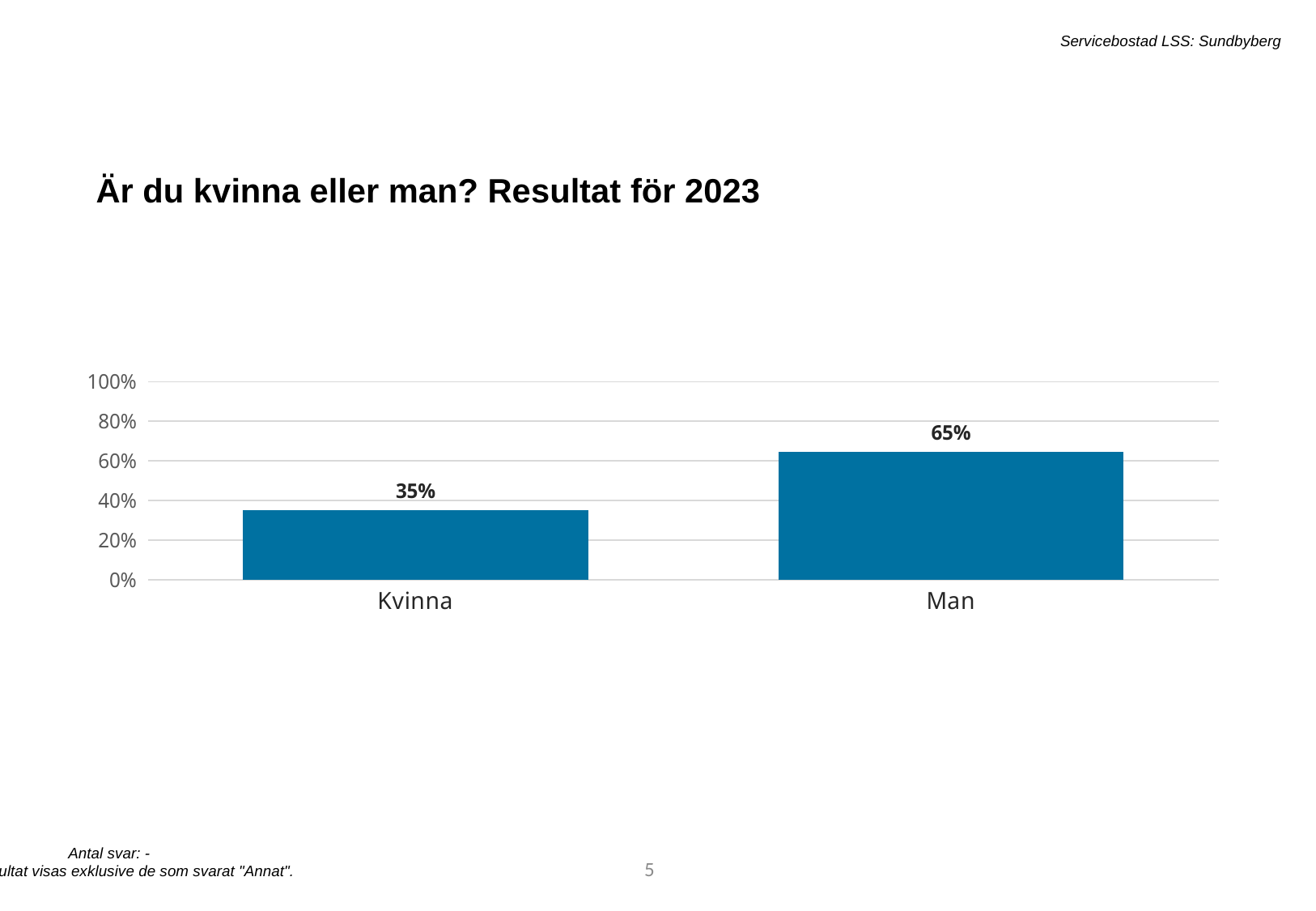
What is the difference between the values for Man and Kvinna? 30% Which category has the lowest value? Kvinna Which is larger, the value for Kvinna or the value for Man? Man What kind of chart is shown on the slide? bar chart What is the highest value shown on the y axis? 100% Is the value for Kvinna greater or less than 40%? less What is the title of the slide's chart? Är du kvinna eller man? Resultat för 2023 How many categories are shown on the x axis? 2 What is the value for Man? 65% What is the value for Kvinna? 35% Which category has the highest value? Man Is the value for Man greater or less than 60%? greater